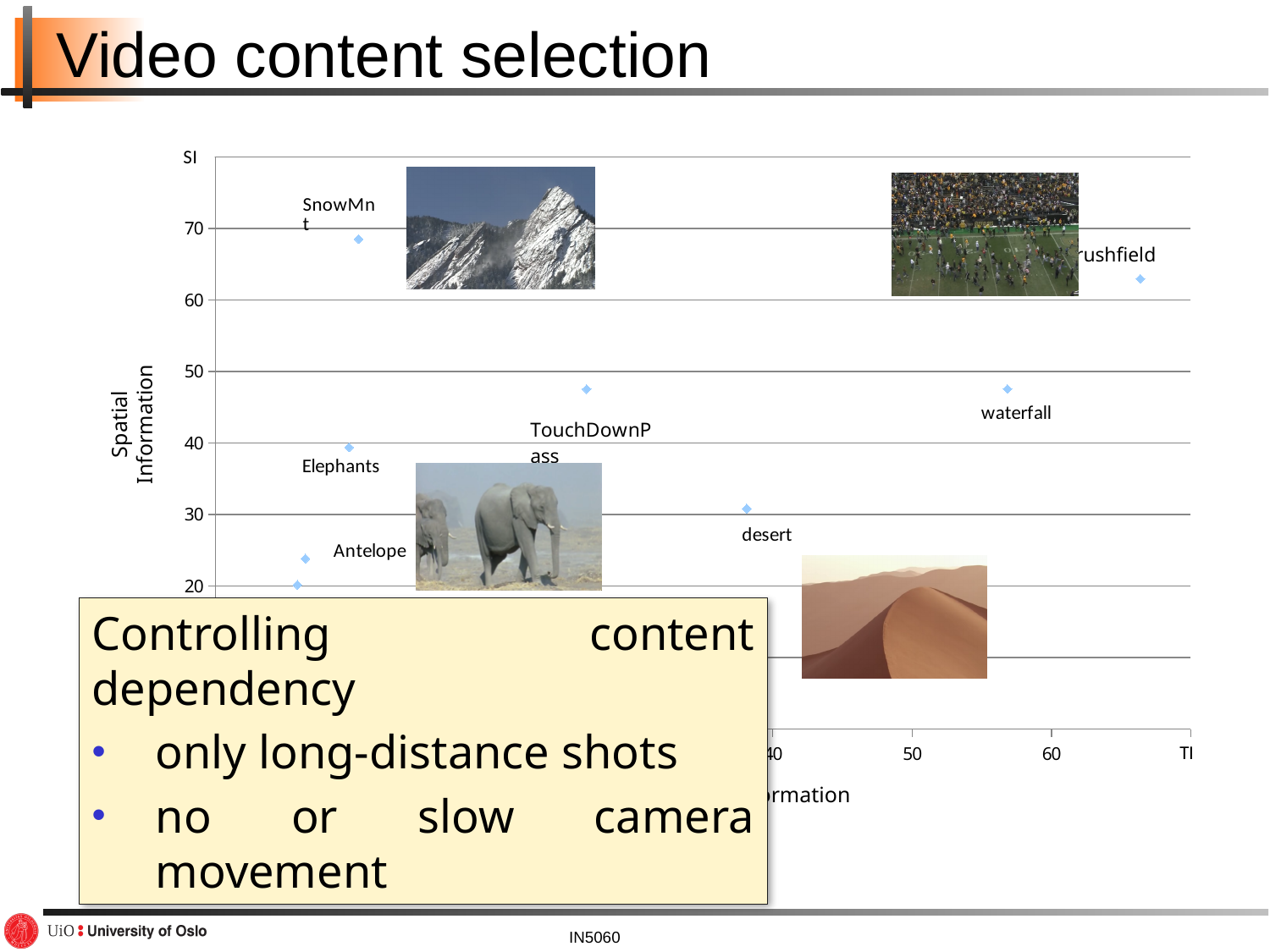
What kind of chart is shown on the slide? scatter chart Is the SI value for waterfall greater or less than 50? less Which has the higher SI value, SnowMnt or rushfield? SnowMnt Is the SI value for Antelope greater or less than 30? less Is the SI value for SnowMnt greater or less than 60? greater What is the label on the vertical axis of the chart? Spatial Information Which has the higher SI value, waterfall or desert? waterfall Which has the higher SI value, Elephants or Antelope? Elephants Which labeled video clip has the highest Spatial Information (SI) value? SnowMnt